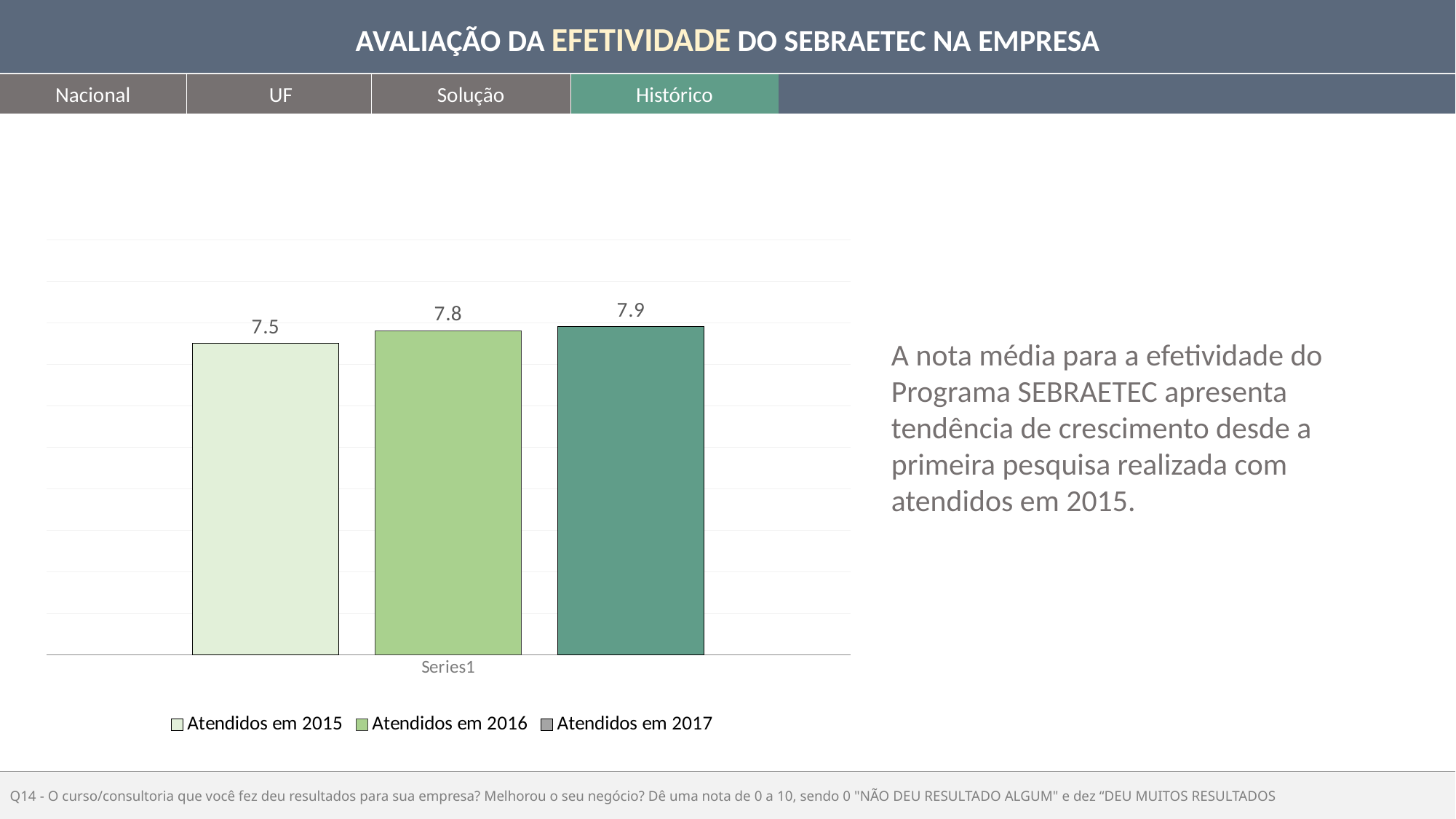
Do the values rise or fall from Atendidos em 2015 to Atendidos em 2017? Rise How many series does the legend list? 3 What kind of chart is shown on the slide? Bar chart What is the value for Atendidos em 2015? 7.5 What is the label shown on the x axis below the bars? Series1 What is the difference between the values for Atendidos em 2016 and Atendidos em 2015? 0.3 Which is larger, the value for Atendidos em 2015 or Atendidos em 2016? Atendidos em 2016 Which series has the lowest value? Atendidos em 2015 Which series has the highest value? Atendidos em 2017 What is the value for Atendidos em 2017? 7.9 What is the value for Atendidos em 2016? 7.8 What is the difference between the values for Atendidos em 2017 and Atendidos em 2015? 0.4